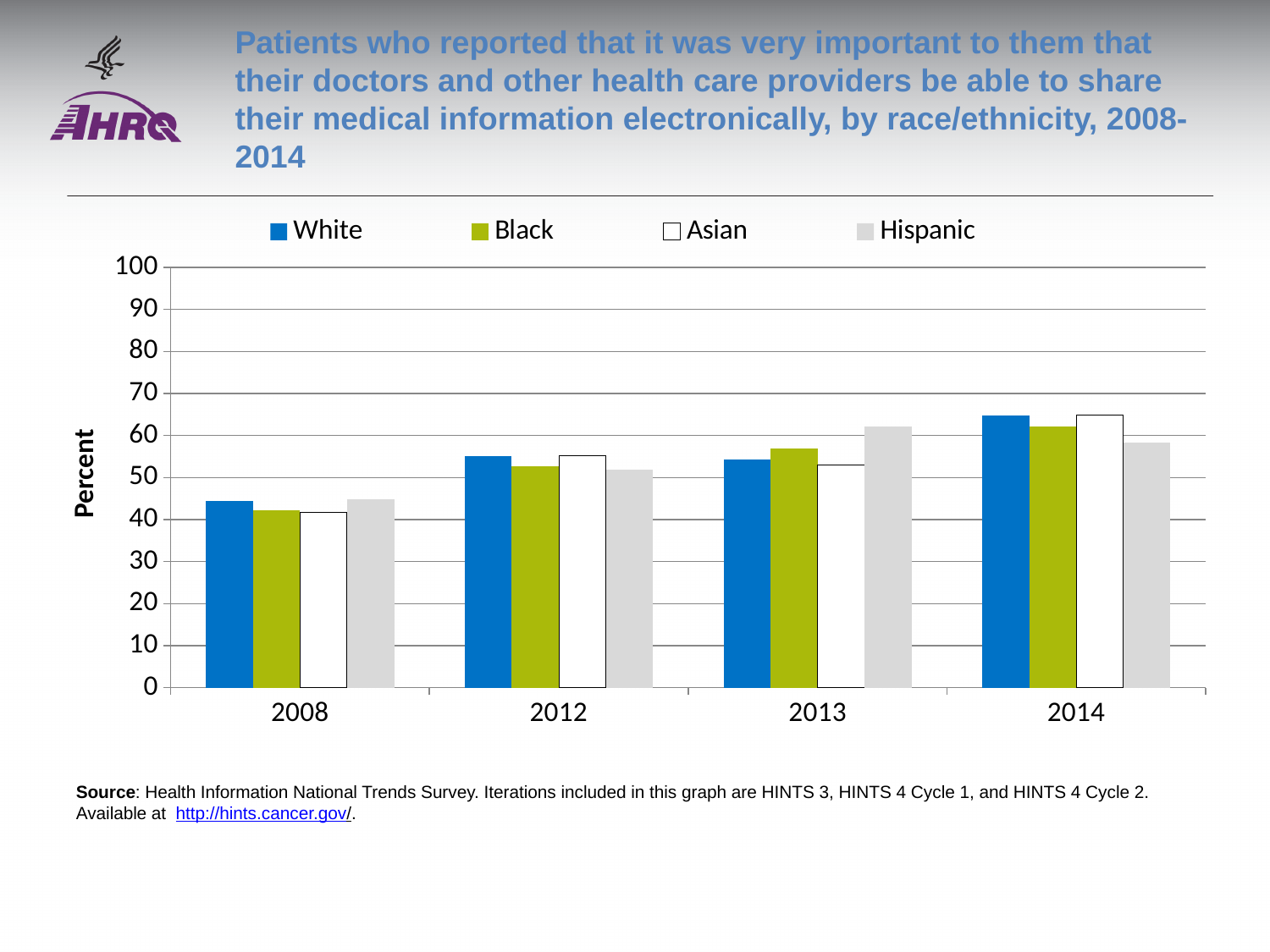
Which race/ethnicity group has the lowest value in 2014? Hispanic Is the value for White in 2014 greater or less than 60? greater In 2013, which is larger, the value for Hispanic or the value for White? Hispanic What kind of chart is shown on the slide? bar chart What is the label on the vertical axis? Percent How many series does the legend list? 4 Which race/ethnicity group has the highest value in 2013? Hispanic Is the value for Hispanic in 2013 greater or less than 60? greater How many years are shown along the x axis? 4 Do the values for Black rise or fall from 2008 to 2014? rise Is the value for Black in 2012 greater or less than 50? greater